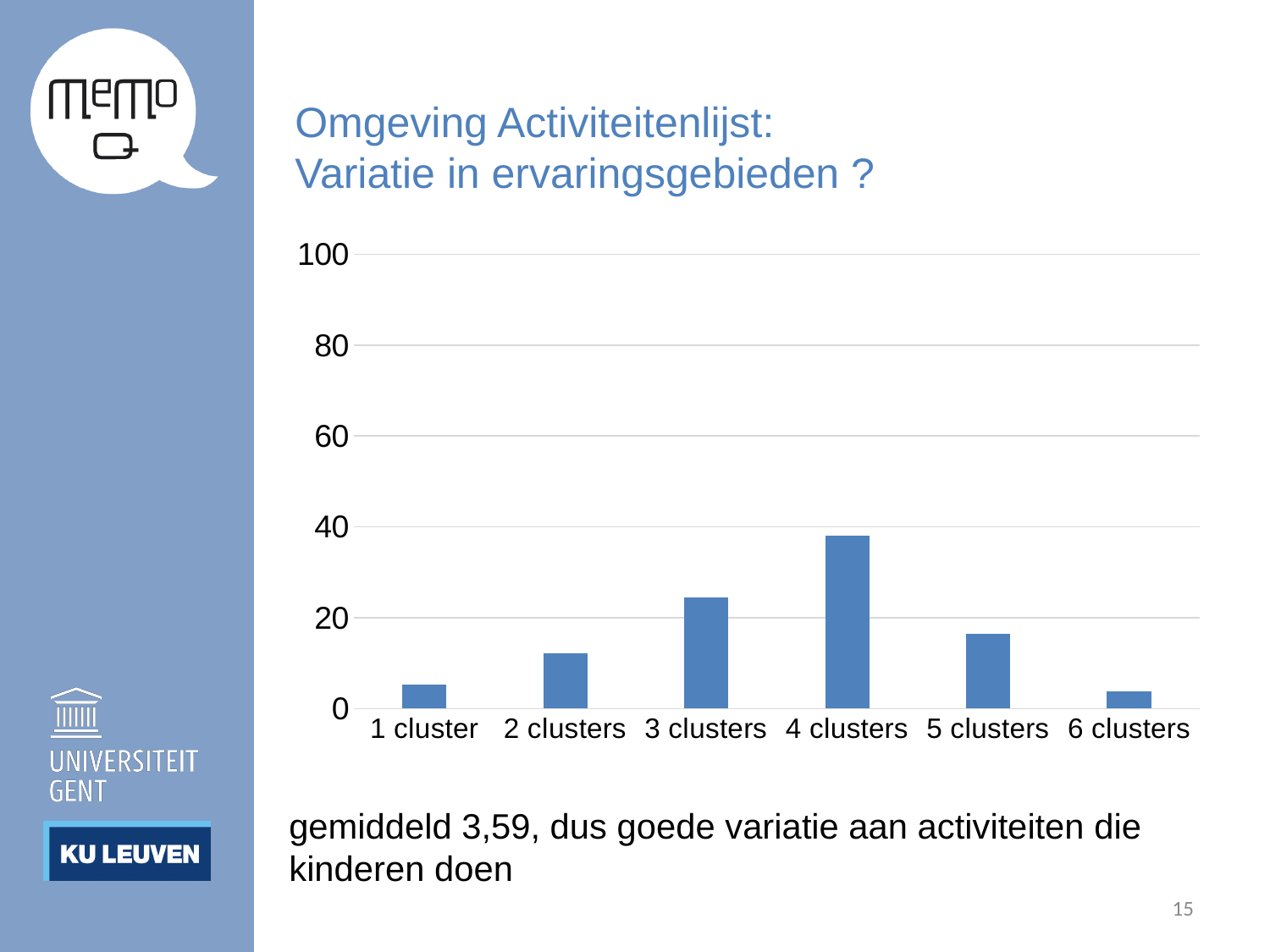
Do the values rise or fall going from 1 cluster to 4 clusters along the x axis? rise How many categories are shown on the x axis of the chart? 6 What kind of chart is shown on the slide? bar chart Is the value for 5 clusters greater or less than 20? less Is the value for 4 clusters greater or less than 20? greater What is the highest tick value shown on the y axis of the chart? 100 Is the value for 4 clusters greater or less than 60? less Which is larger, the value for 3 clusters or the value for 5 clusters? 3 clusters Which is larger, the value for 2 clusters or the value for 5 clusters? 5 clusters Which category has the highest bar in the chart? 4 clusters